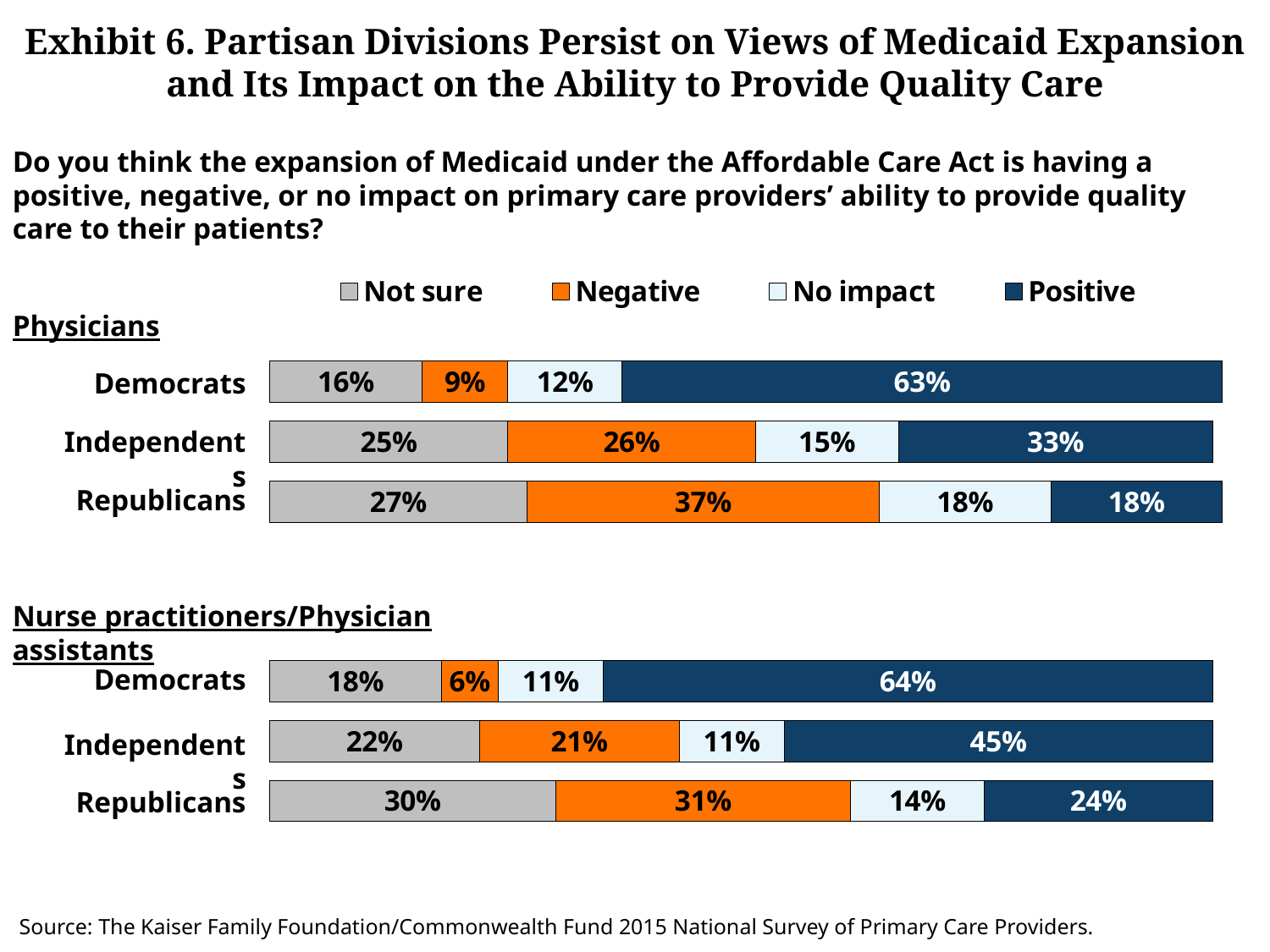
In the Nurse practitioners/Physician assistants chart, what percentage of Independents say there is no impact? 11% In the Nurse practitioners/Physician assistants chart, which is larger: the Negative percentage for Republicans or the Positive percentage for Republicans? Negative percentage for Republicans In the Physicians chart, which party group has the highest Positive percentage? Democrats In the Physicians chart, what percentage of Democrats say Medicaid expansion is having a positive impact? 63% In the Nurse practitioners/Physician assistants chart, which party group has the lowest Negative percentage? Democrats In the Physicians chart, what is the difference between the Positive percentage for Democrats and the Positive percentage for Republicans? 45 percentage points How many party groups are shown in the Physicians chart? 3 Which colour represents the Negative response in the legend? Orange What kind of chart is used on this slide? Stacked bar chart In the Physicians chart, what percentage of Republicans say Medicaid expansion is having a negative impact? 37% How many series does the legend list? 4 In the Nurse practitioners/Physician assistants chart, what percentage of Republicans are not sure? 30%